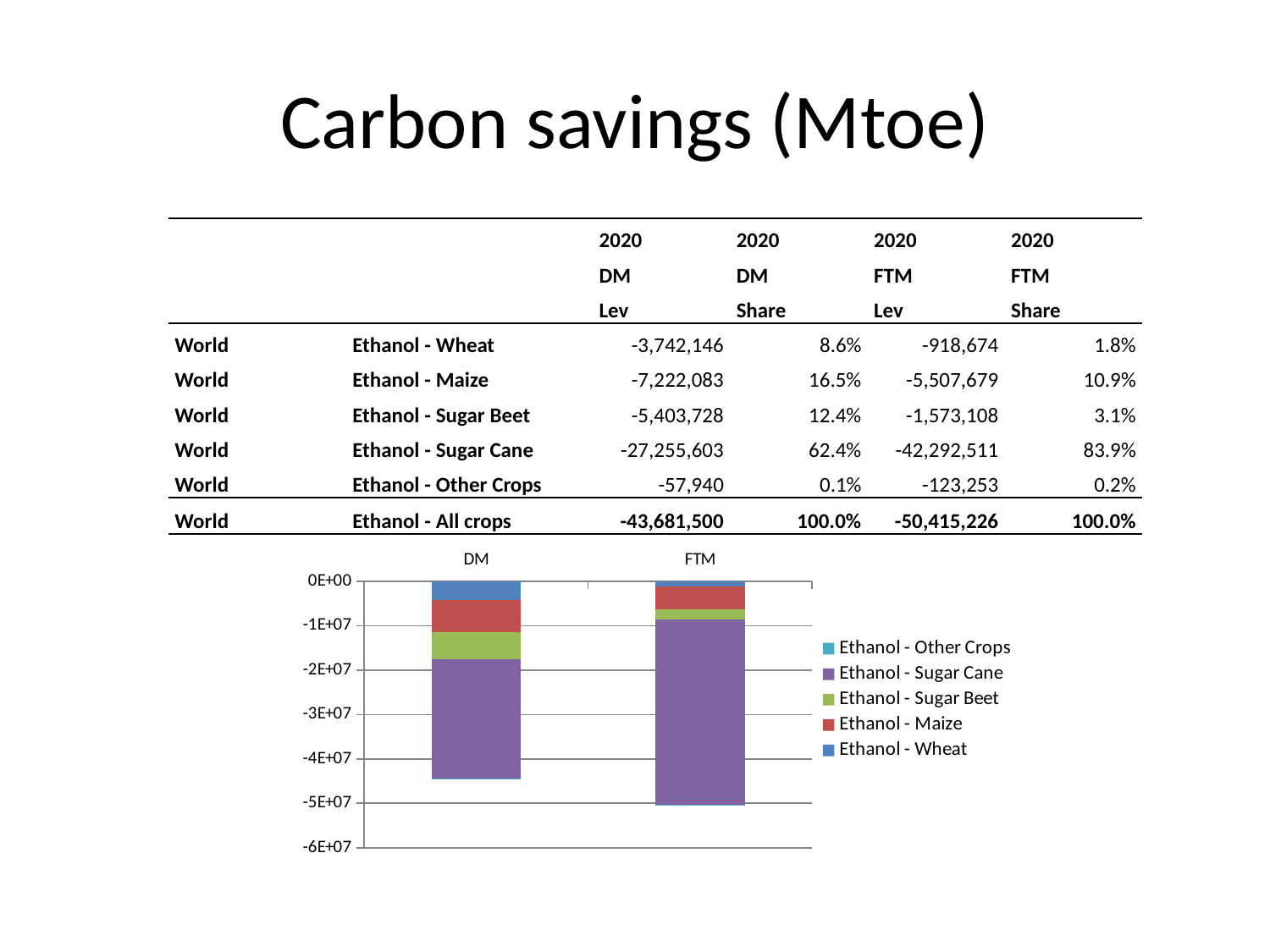
Is the Ethanol - Wheat segment of the DM bar greater or less than -1E+07? greater How many categories are plotted on the x axis of the chart? 2 Is the total value of the FTM bar greater or less than -4E+07? less How many series does the chart legend list? 5 Is the total value of the DM bar greater or less than -4E+07? less Which series accounts for the largest segment of the FTM bar? Ethanol - Sugar Cane Which series has the smallest segment in the DM bar? Ethanol - Other Crops Which bar extends further below zero, DM or FTM? FTM What kind of chart is shown below the table? stacked bar chart Which series accounts for the largest segment of the DM bar? Ethanol - Sugar Cane What colour represents Ethanol - Sugar Cane in the chart? purple What is the lowest value shown on the chart's y axis? -6E+07